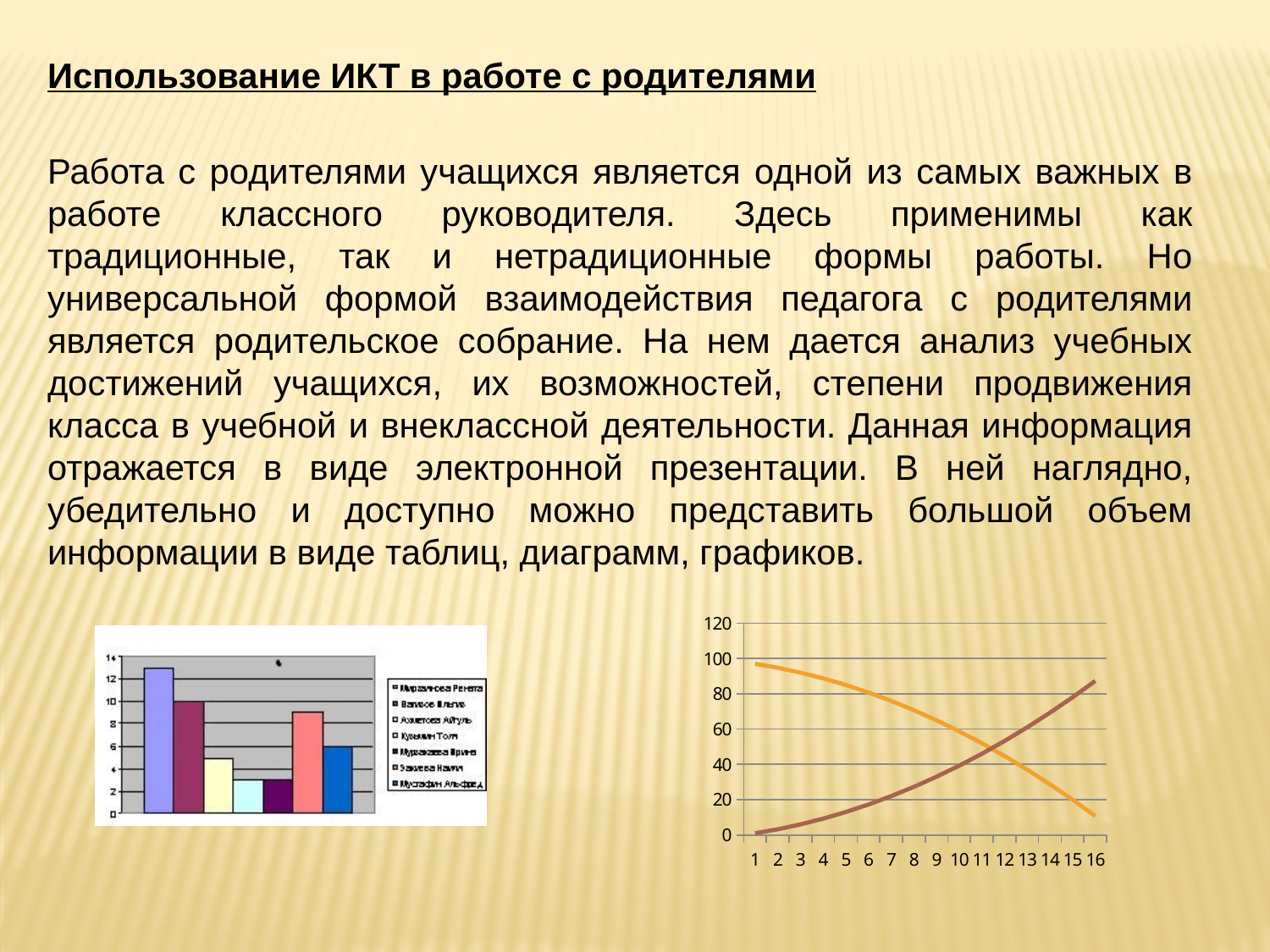
In the chart on the right, how many lines are plotted? 2 In the chart on the left, how many bars are plotted? 7 In the chart on the right, does the brown line rise or fall as the x axis goes from 1 to 16? rise In the chart on the right, is the value of the orange line at x = 16 greater or less than 20? less In the chart on the right, is the value of the orange line at x = 1 greater or less than 80? greater What kind of chart is the chart on the left of the slide? bar chart In the chart on the right, does the orange line rise or fall as the x axis goes from 1 to 16? fall In the chart on the right, is the value of the brown line at x = 1 greater or less than 20? less In the chart on the right, how many points are labelled along the x axis? 16 In the chart on the right, which line is higher at x = 16, the orange line or the brown line? the brown line What kind of chart is the chart on the right of the slide? line chart